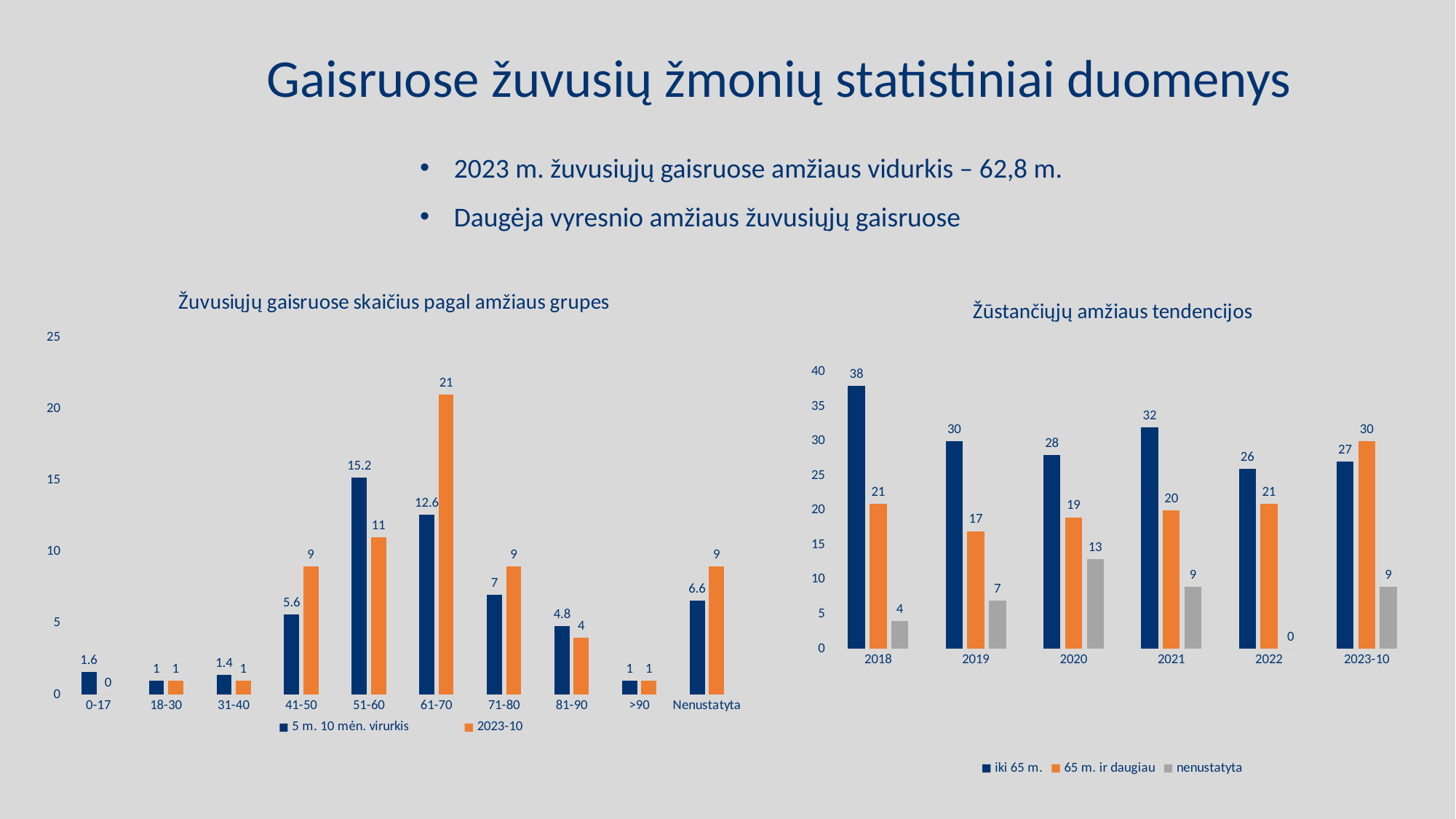
In the chart "Žuvusiųjų gaisruose skaičius pagal amžiaus grupes", what is the 2023-10 value for the 61-70 age group? 21 In the chart "Žuvusiųjų gaisruose skaičius pagal amžiaus grupes", what is the difference between the 2023-10 value and the "5 m. 10 mėn. virurkis" value for the 41-50 age group? 3.4 What kind of chart is "Žūstančiųjų amžiaus tendencijos"? Bar chart In the chart "Žūstančiųjų amžiaus tendencijos", what is the "nenustatyta" value for 2020? 13 In the chart "Žūstančiųjų amžiaus tendencijos", how many series does the legend list? 3 In the chart "Žuvusiųjų gaisruose skaičius pagal amžiaus grupes", how many age-group categories are shown on the x axis? 10 In the chart "Žuvusiųjų gaisruose skaičius pagal amžiaus grupes", what is the "5 m. 10 mėn. virurkis" value for the 51-60 age group? 15.2 In the chart "Žūstančiųjų amžiaus tendencijos", what is the "iki 65 m." value for 2018? 38 In the chart "Žūstančiųjų amžiaus tendencijos", what is the difference between the "65 m. ir daugiau" value and the "iki 65 m." value for 2023-10? 3 In the chart "Žuvusiųjų gaisruose skaičius pagal amžiaus grupes", which is larger for the 51-60 group: the "5 m. 10 mėn. virurkis" value or the 2023-10 value? 5 m. 10 mėn. virurkis In the chart "Žuvusiųjų gaisruose skaičius pagal amžiaus grupes", which age group has the highest 2023-10 value? 61-70 In the chart "Žūstančiųjų amžiaus tendencijos", which year has the lowest "iki 65 m." value? 2022